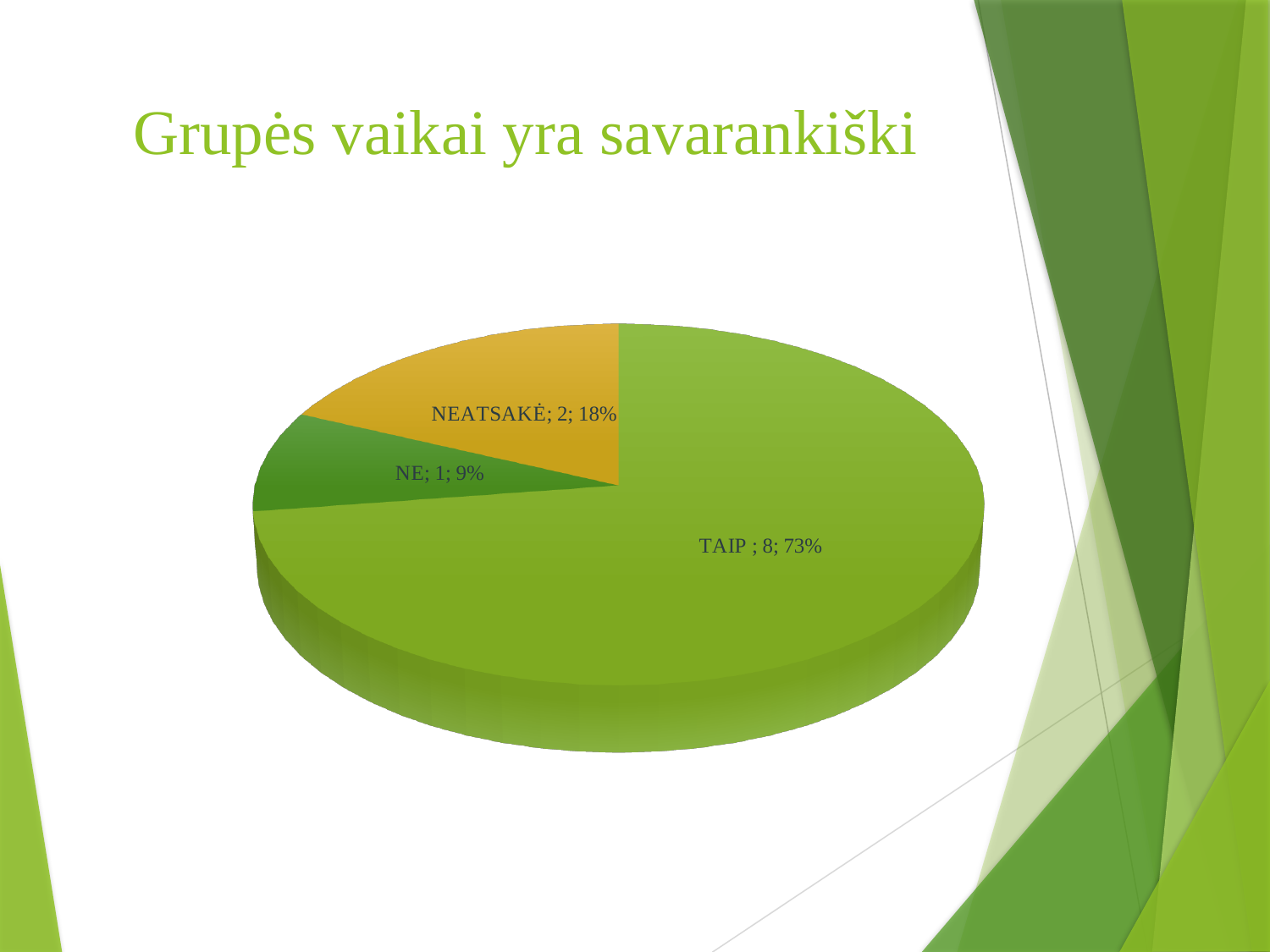
What is the difference between the counts for TAIP and NEATSAKĖ? 6 What is the count for NEATSAKĖ? 2 What share of the pie does NE represent? 9% What kind of chart is shown on the slide? pie chart Which category has the smallest slice? NE What is the count for NE? 1 What is the title of the slide? Grupės vaikai yra savarankiški What share of the pie does NEATSAKĖ represent? 18% What share of the pie does TAIP represent? 73% Which category has the largest slice? TAIP How many slices does the pie chart have? 3 What is the count for TAIP? 8